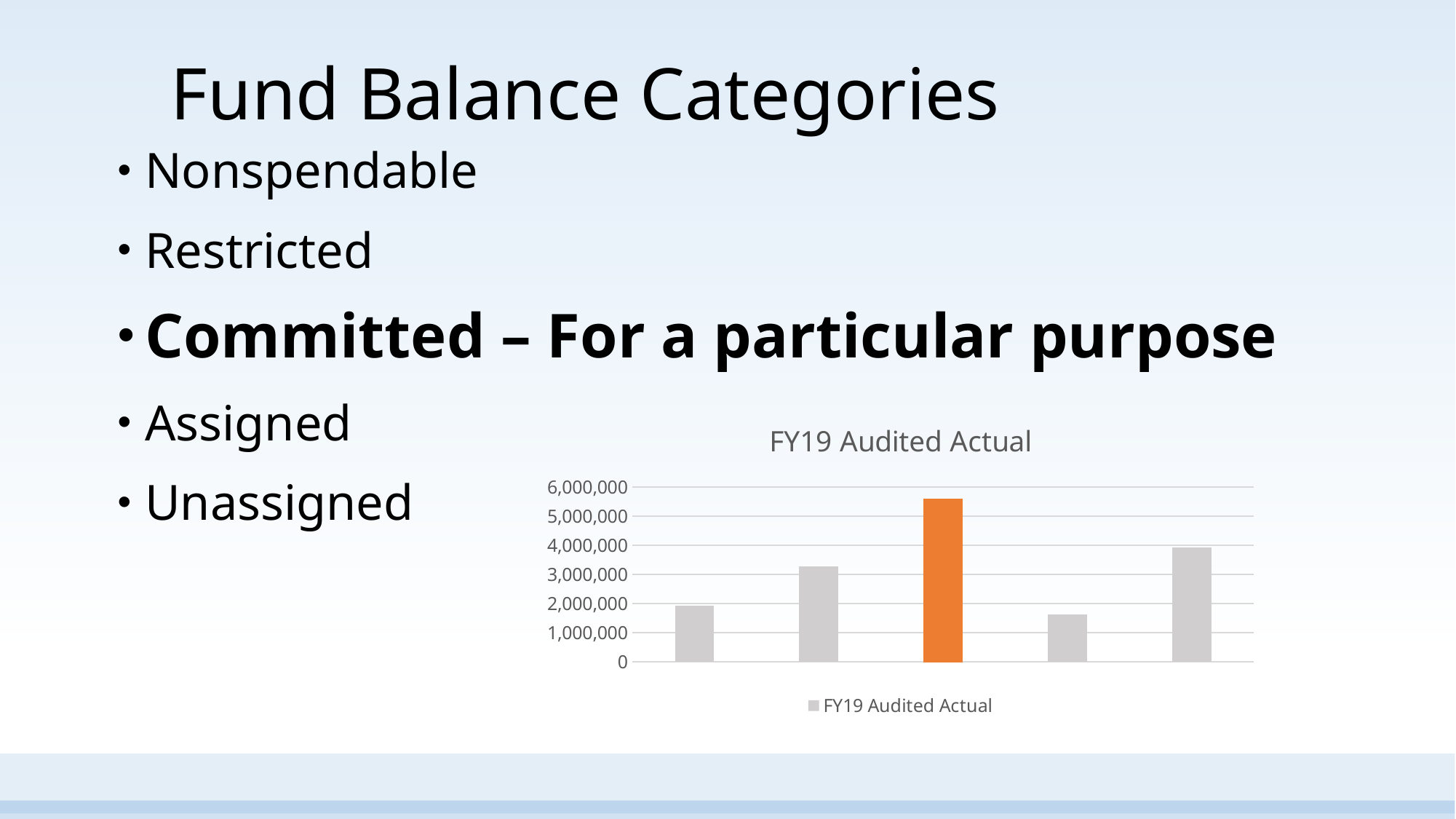
How many bars are plotted in the FY19 Audited Actual chart? 5 Which bar in the chart has the lowest value? the fourth bar Which is larger, the second bar or the fifth bar? the fifth bar Which bar in the chart is highlighted in orange? the third bar Which bar in the chart has the highest value? the third bar (orange) Is the value of the second bar greater or less than 3,000,000? greater Is the value of the third (orange) bar greater or less than 5,000,000? greater What kind of chart is shown on the slide? bar chart What is the title of the chart? FY19 Audited Actual How many series does the legend of the chart list? 1